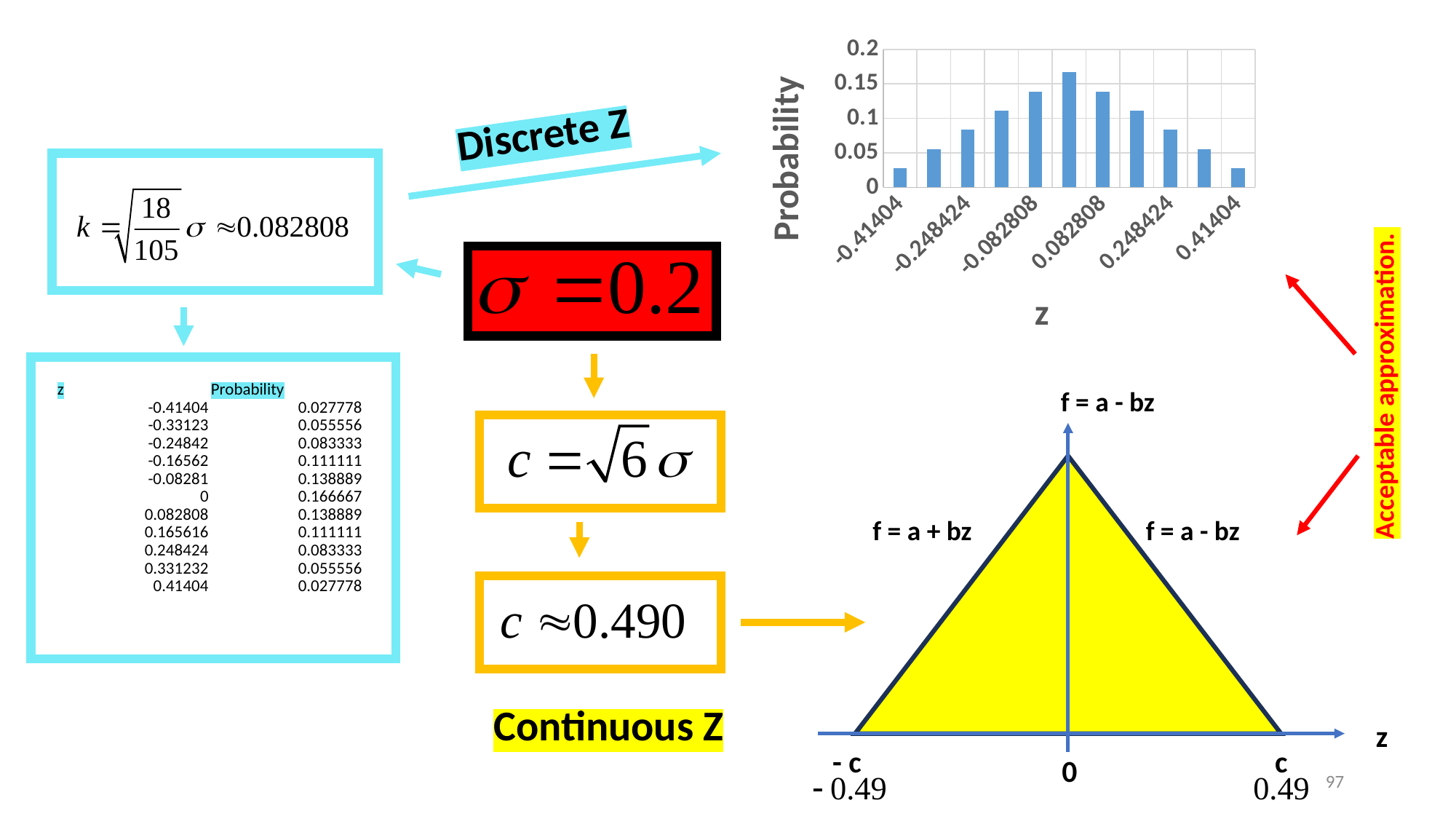
In the Probability bar chart, do the values rise or fall as z goes from -0.41404 to -0.082808? rise In the Probability bar chart, which is larger: the value for z = -0.082808 or the value for z = -0.41404? -0.082808 In the Probability bar chart, do the values rise or fall as z goes from 0.082808 to 0.41404? fall In the Probability bar chart, is the tallest bar greater or less than 0.15? greater In the Probability bar chart, is the value for z = 0.248424 greater or less than 0.1? less In the Probability bar chart, is the value for z = 0.082808 greater or less than 0.15? less How many bars are plotted in the Probability bar chart? 11 What kind of chart is the Probability vs z chart at the top right of the slide? bar chart What is the title of the vertical axis of the bar chart at the top right? Probability